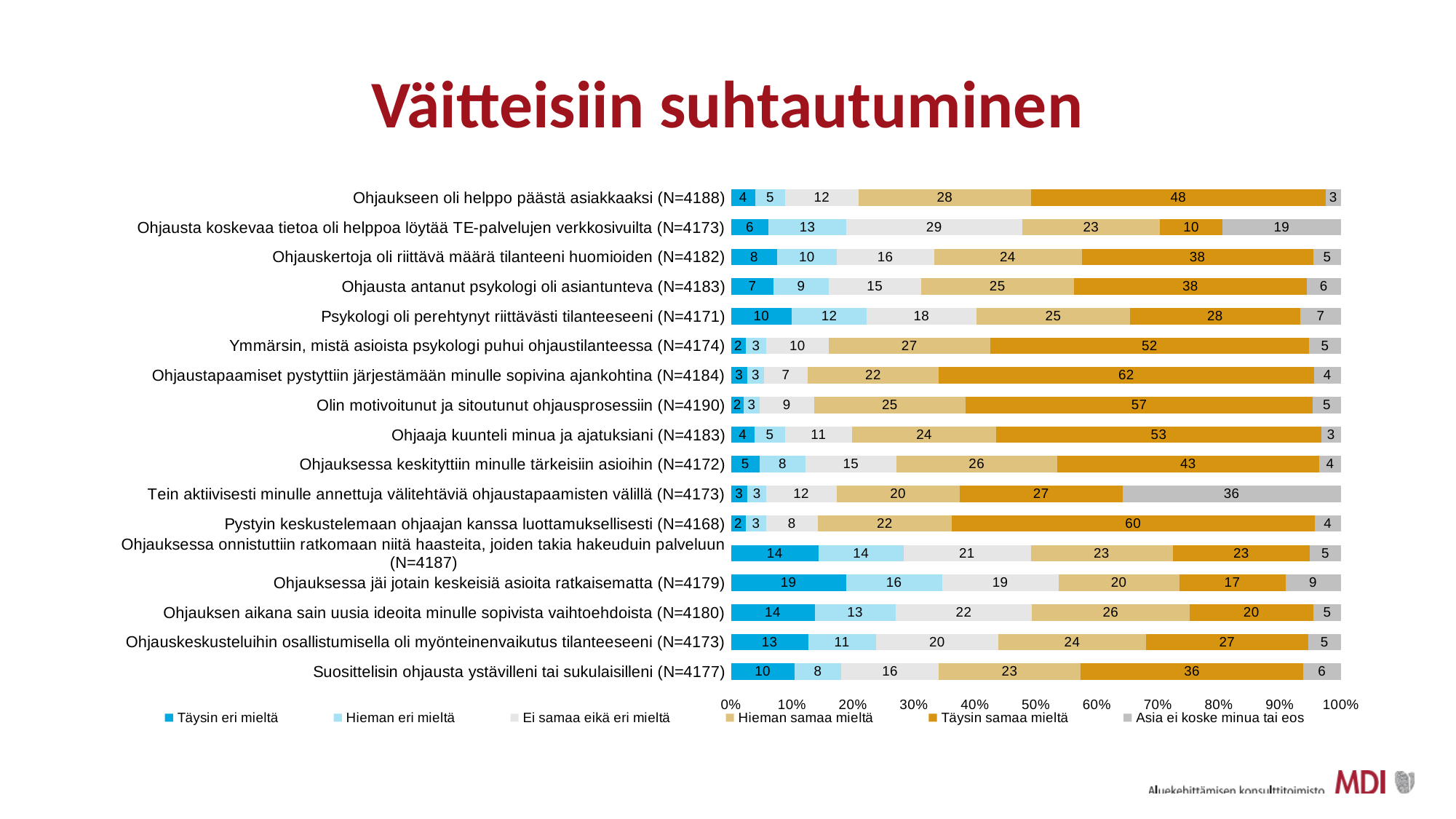
Which statement has the highest 'Täysin samaa mieltä' value? Ohjaustapaamiset pystyttiin järjestämään minulle sopivina ajankohtina (N=4184) What is the 'Täysin samaa mieltä' value for 'Ohjaustapaamiset pystyttiin järjestämään minulle sopivina ajankohtina (N=4184)'? 62 Which statement has the lowest 'Täysin samaa mieltä' value? Ohjausta koskevaa tietoa oli helppoa löytää TE-palvelujen verkkosivuilta (N=4173) How many statements (categories) are plotted in the chart? 17 How many series does the legend list? 6 What is the 'Asia ei koske minua tai eos' value for 'Tein aktiivisesti minulle annettuja välitehtäviä ohjaustapaamisten välillä (N=4173)'? 36 What kind of chart is shown on the slide? Stacked bar chart Which legend entry is shown in dark blue? Täysin eri mieltä What is the difference between the 'Täysin samaa mieltä' values for 'Ohjaukseen oli helppo päästä asiakkaaksi (N=4188)' and 'Ohjauskertoja oli riittävä määrä tilanteeni huomioiden (N=4182)'? 10 What is the title of the slide? Väitteisiin suhtautuminen What is the 'Täysin eri mieltä' value for 'Ohjauksessa jäi jotain keskeisiä asioita ratkaisematta (N=4179)'? 19 Which has the larger 'Hieman samaa mieltä' value: 'Ohjaukseen oli helppo päästä asiakkaaksi (N=4188)' or 'Ohjausta koskevaa tietoa oli helppoa löytää TE-palvelujen verkkosivuilta (N=4173)'? Ohjaukseen oli helppo päästä asiakkaaksi (N=4188)